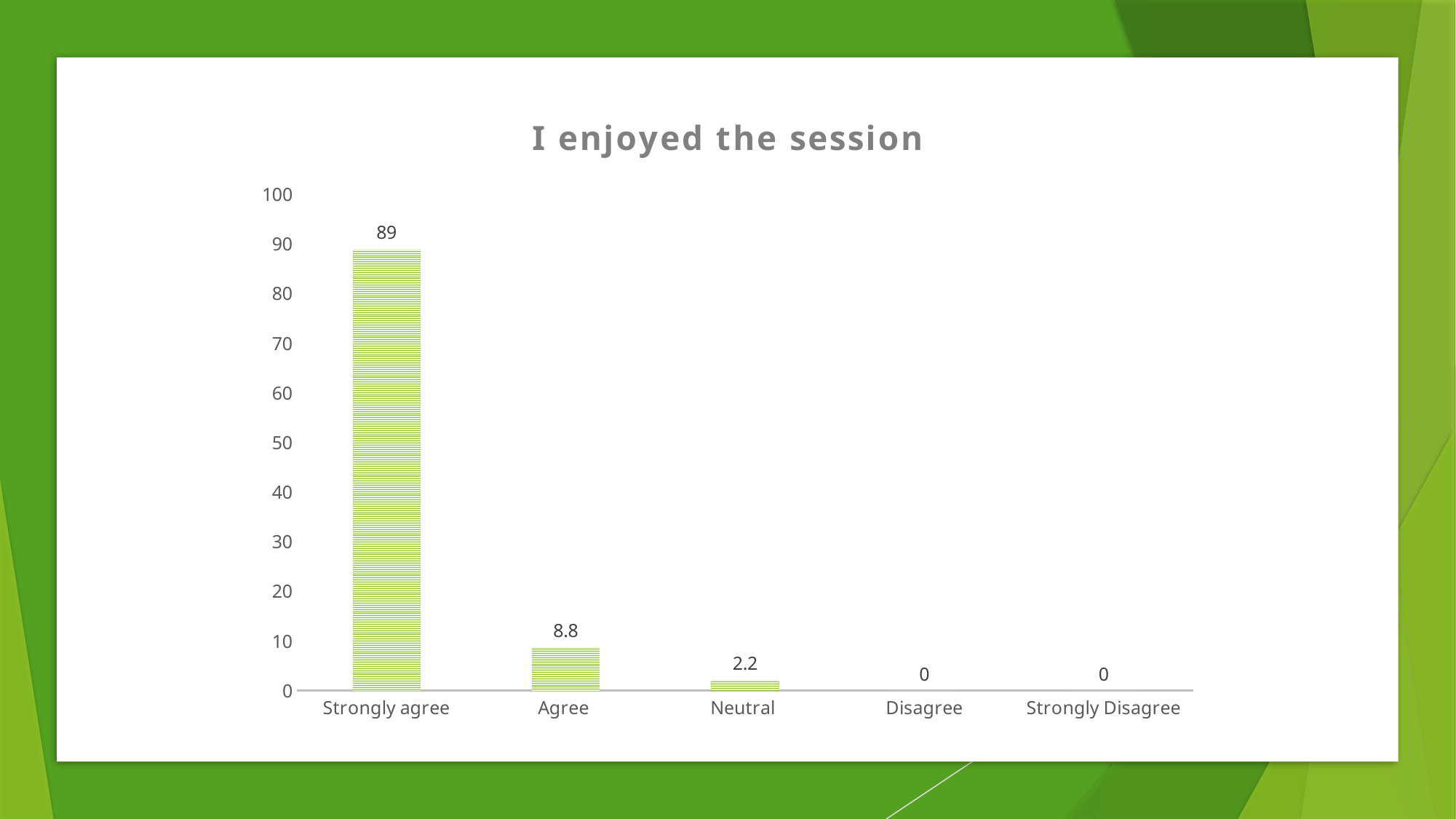
What is the value for Disagree? 0 What kind of chart is shown on the slide? Bar chart Is the value for Strongly agree greater or less than 80? greater How many categories are shown on the x axis? 5 What is the difference between the values for Strongly agree and Agree? 80.2 What is the difference between the values for Agree and Neutral? 6.6 What is the value for Neutral? 2.2 Which category has the highest value? Strongly agree What is the value for Agree? 8.8 What is the value for Strongly agree? 89 What is the title of the chart? I enjoyed the session Which is larger, the value for Agree or the value for Neutral? Agree